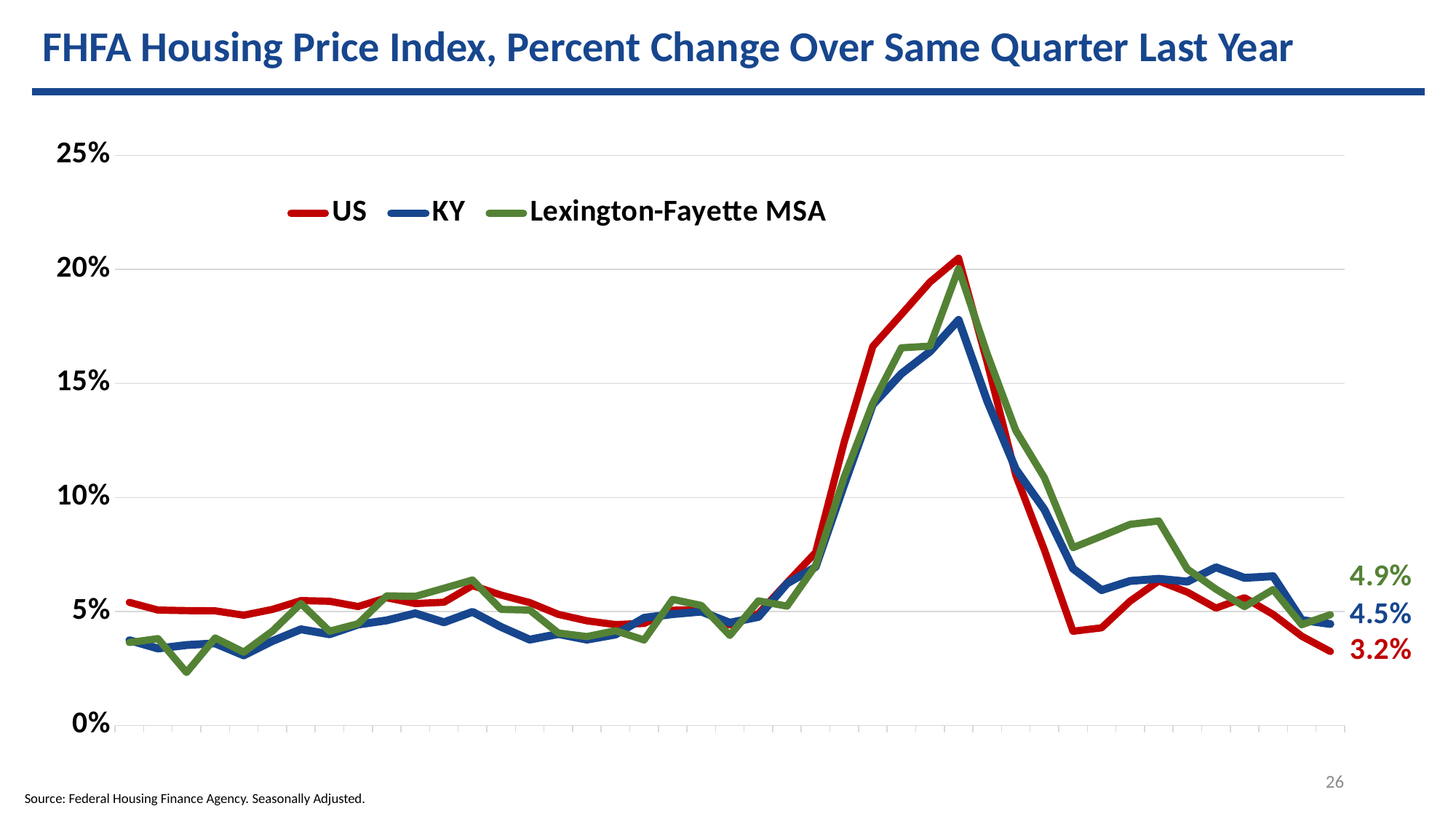
What is the most recent value shown for the Lexington-Fayette MSA series? 4.9% At the end of the chart, is the KY value larger or smaller than the US value? Larger What is the difference between the final Lexington-Fayette MSA value and the final US value? 1.7 percentage points How many series does the legend list? 3 Does the US series rise or fall from its peak to the end of the chart? Fall Which colour is used for the US series? Red Is the peak value of the KY series greater or less than 20%? less Which series has the highest value at the end of the chart? Lexington-Fayette MSA What is the most recent value shown for the KY series? 4.5% What is the most recent value shown for the US series? 3.2% Which series has the lowest value at the end of the chart? US What kind of chart is shown on the slide? Line chart